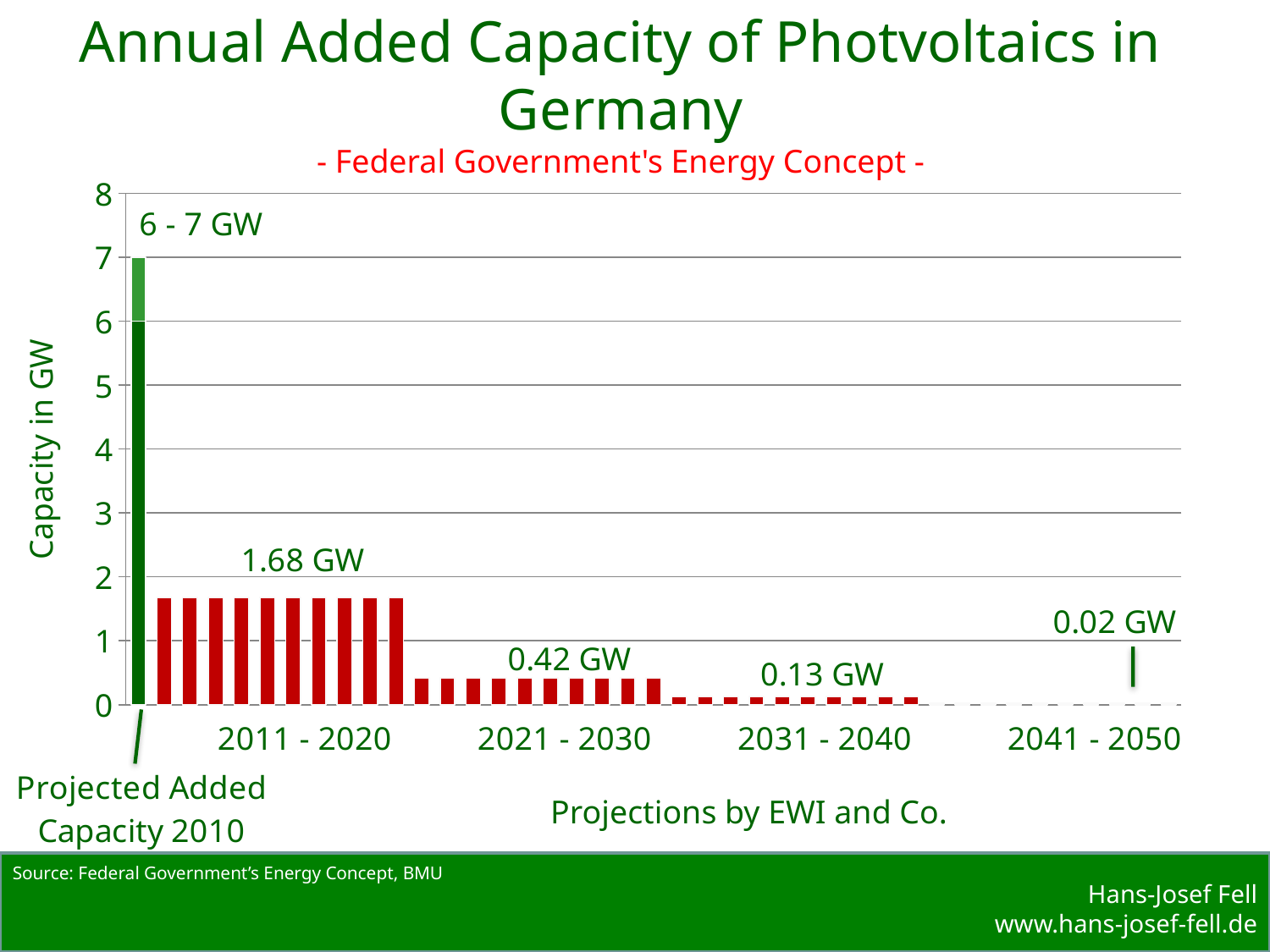
What is the annual added capacity shown for the period 2041 - 2050? 0.02 GW What kind of chart is shown on the slide? bar chart What is the annual added capacity shown for the period 2011 - 2020? 1.68 GW What is the annual added capacity shown for the period 2021 - 2030? 0.42 GW Which decade period has the lowest annual added capacity? 2041 - 2050 Do the annual added capacity values rise or fall from 2011 - 2020 to 2041 - 2050? fall What is the label of the vertical axis? Capacity in GW What is the difference between the annual added capacity for 2011 - 2020 and for 2021 - 2030? 1.26 GW Which decade period has the highest annual added capacity? 2011 - 2020 Which is larger, the annual added capacity for 2021 - 2030 or for 2031 - 2040? 2021 - 2030 What is the annual added capacity shown for the period 2031 - 2040? 0.13 GW What is the projected added capacity labelled for 2010? 6 - 7 GW